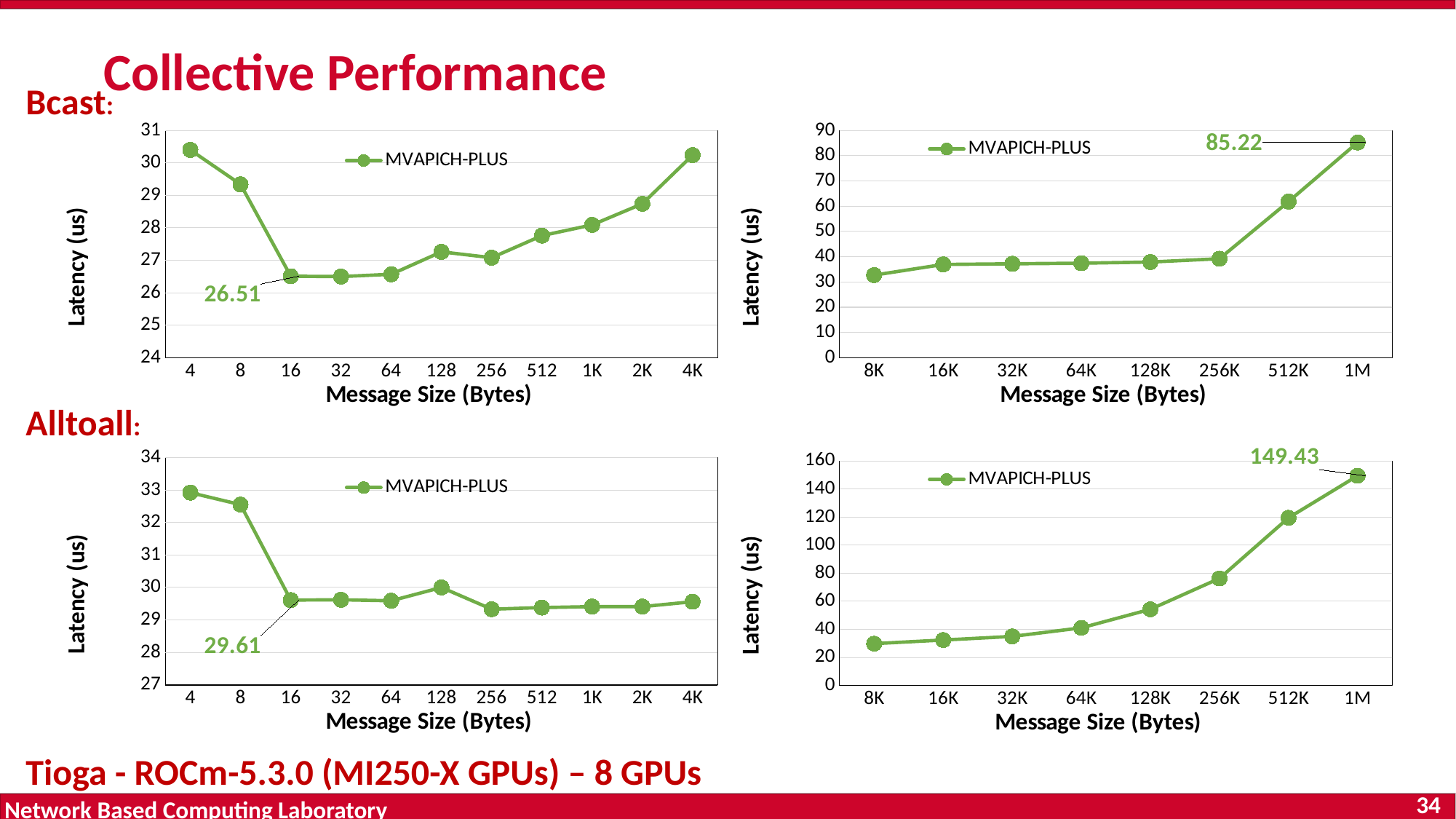
In the top-left Bcast chart (4 to 4K bytes), which message size has the highest latency? 4 In the top-right Bcast chart (8K to 1M), which message size has the highest latency? 1M In the top-right Bcast chart (8K to 1M), is the latency at 256K greater or less than 50? less What type of chart is the top-left Bcast chart? Line chart In the bottom-right Alltoall chart (message sizes 8K to 1M), what is the labeled latency at message size 1M? 149.43 In the bottom-right Alltoall chart (8K to 1M), which message size has the lowest latency? 8K In the top-right Bcast chart (message sizes 8K to 1M), what is the labeled latency at message size 1M? 85.22 In the bottom-right Alltoall chart (8K to 1M), does latency rise or fall as message size increases? Rises In the bottom-right Alltoall chart (8K to 1M), is the latency at 512K greater or less than 100? greater How many message-size points are plotted in the bottom-right Alltoall chart (8K to 1M)? 8 In the top-left Bcast chart (message sizes 4 to 4K bytes), what is the labeled latency at message size 16? 26.51 In the bottom-left Alltoall chart (message sizes 4 to 4K bytes), what is the labeled latency at message size 16? 29.61